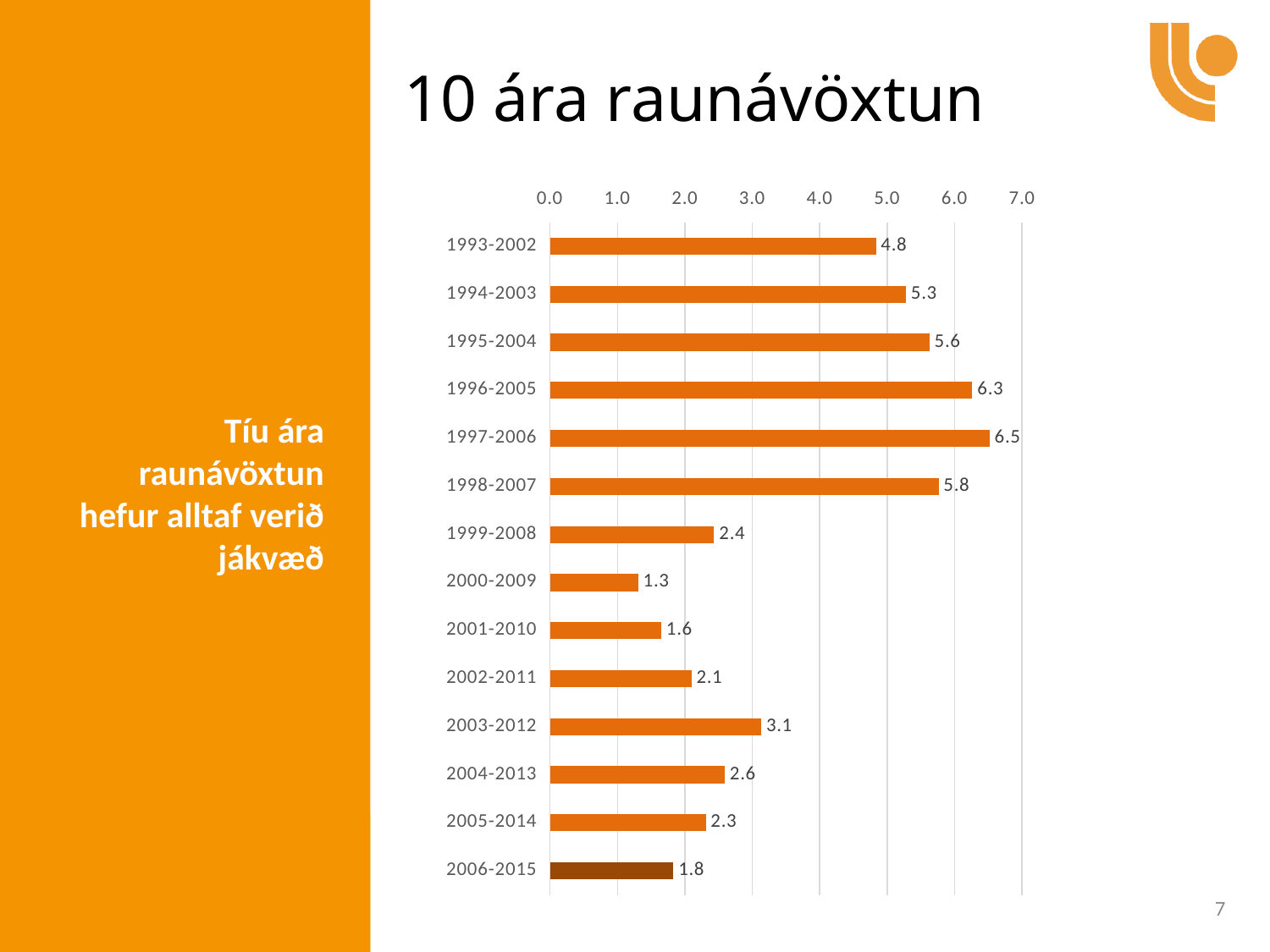
What is the difference between the values for 1996-2005 and 2003-2012? 3.2 Do the values rise or fall from 1993-2002 to 1997-2006? rise What is the value for 1997-2006? 6.5 What is the value for 1999-2008? 2.4 Which is larger, the value for 1994-2003 or the value for 1998-2007? 1998-2007 Which period has the lowest value? 2000-2009 What kind of chart is shown on the slide? bar chart What is the title of the chart? 10 ára raunávöxtun Which period has the highest value? 1997-2006 Is the value for 1995-2004 greater or less than 5.0? greater How many periods are shown on the chart? 14 What is the value for 2006-2015? 1.8